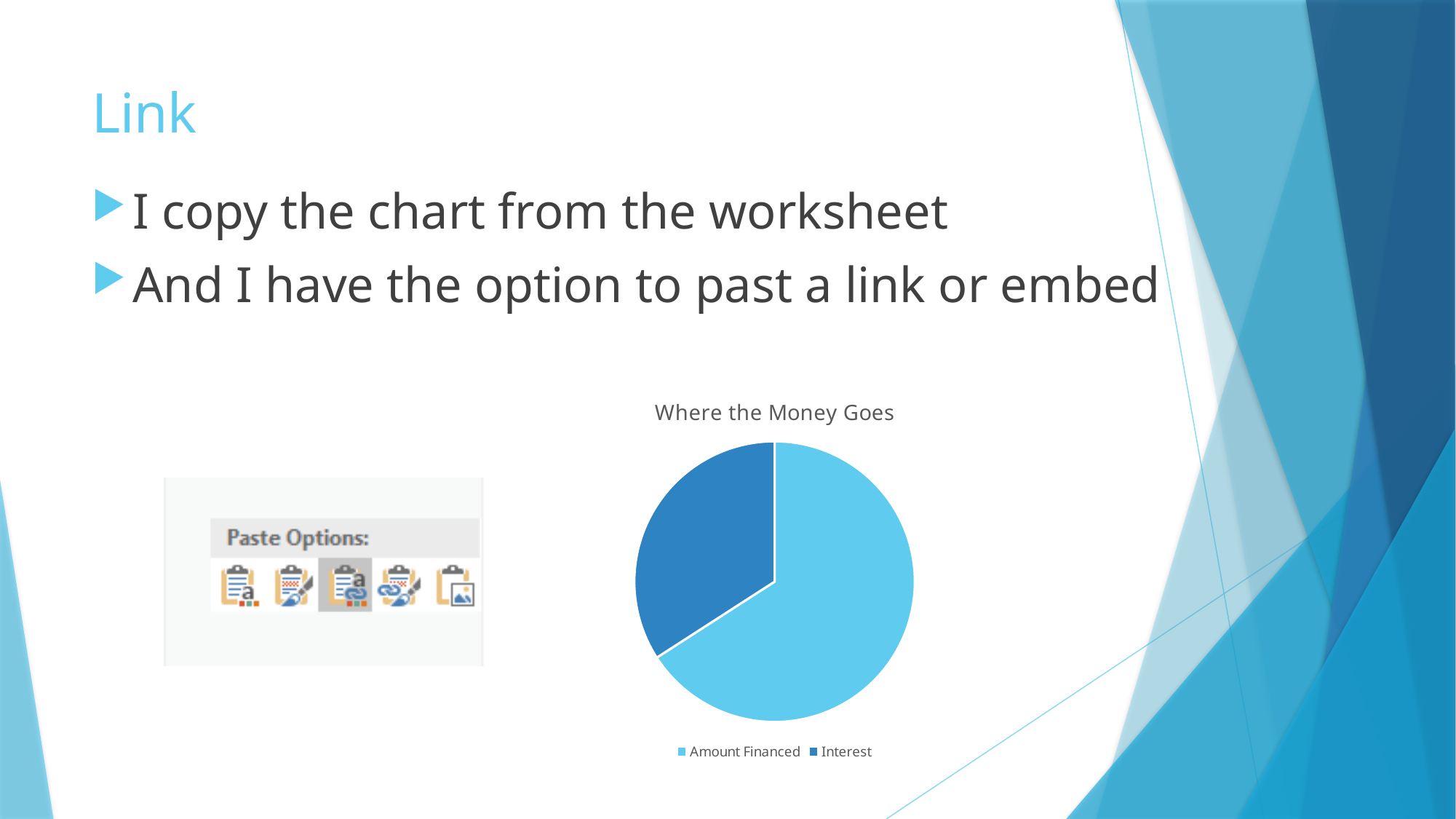
Does the Amount Financed slice take up more or less than half of the pie? more How many entries does the chart's legend list? 2 What is the title of the chart on the slide? Where the Money Goes Which is larger in the pie chart, Amount Financed or Interest? Amount Financed Which slice of the pie chart is the largest? Amount Financed Which slice of the pie chart is the smallest? Interest How many slices does the pie chart have? 2 What kind of chart is shown on the slide? pie chart Which legend entry is shown in the darker blue colour? Interest